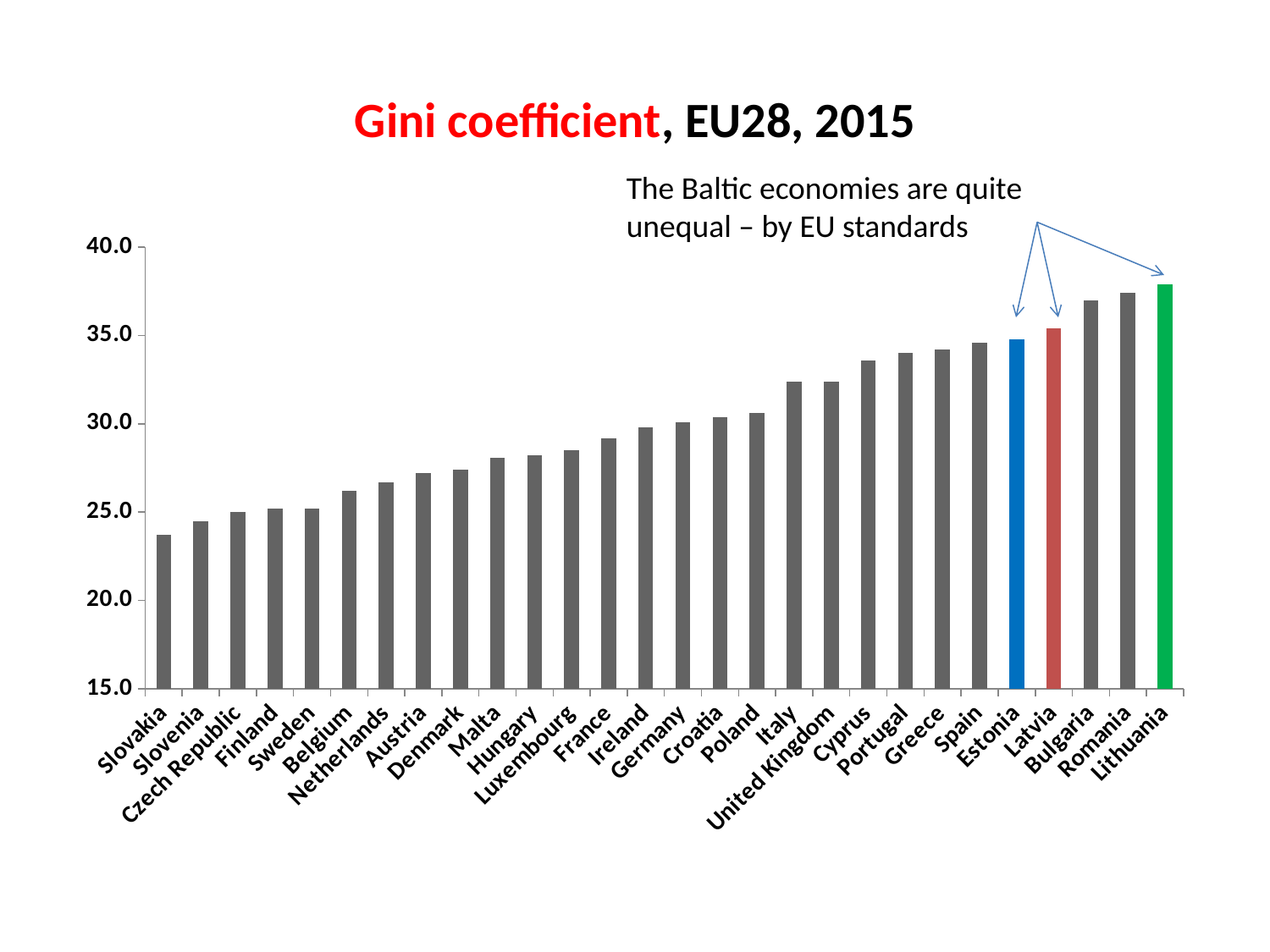
Which country has the lowest Gini coefficient in the chart? Slovakia Which has the larger Gini coefficient, Slovakia or Slovenia? Slovenia Is the value for Italy greater or less than 30.0? greater Which has the larger Gini coefficient, Estonia or Lithuania? Lithuania Is the value for Belgium greater or less than 30.0? less What colour is the bar for Lithuania? Green Is the value for Lithuania greater or less than 35.0? greater What kind of chart is shown on the slide? Bar chart Which country has the highest Gini coefficient in the chart? Lithuania Do the values rise or fall moving from left to right along the x axis? Rise How many countries are shown on the x axis of the chart? 28